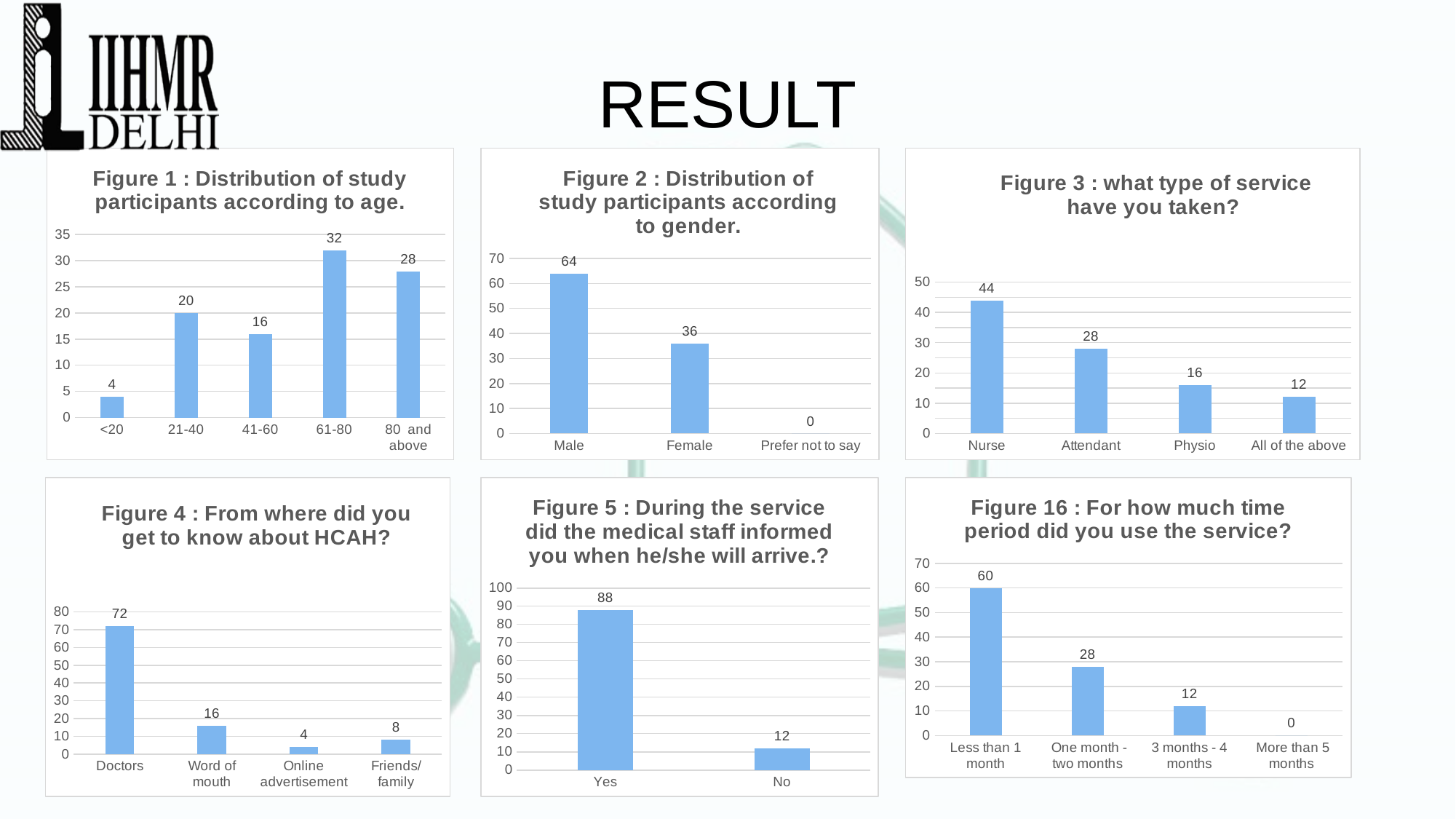
In Figure 3 (what type of service have you taken?), what is the value for Physio? 16 In Figure 2 (Distribution of study participants according to gender), how many categories are shown on the x axis? 3 In Figure 2 (Distribution of study participants according to gender), what is the difference between the Male and Female values? 28 In Figure 1 (Distribution of study participants according to age), what is the value for the 61-80 age group? 32 In Figure 4 (From where did you get to know about HCAH?), which is larger, Word of mouth or Friends/family? Word of mouth What kind of chart is Figure 5 (During the service did the medical staff informed you when he/she will arrive.?)? bar chart In Figure 1 (Distribution of study participants according to age), which age group has the lowest value? <20 In Figure 16 (For how much time period did you use the service?), what is the value for More than 5 months? 0 In Figure 4 (From where did you get to know about HCAH?), what is the value for Online advertisement? 4 In Figure 16 (For how much time period did you use the service?), do the values rise or fall from left to right along the x axis? fall In Figure 3 (what type of service have you taken?), which category has the highest value? Nurse In Figure 5 (During the service did the medical staff informed you when he/she will arrive.?), what is the value for Yes? 88